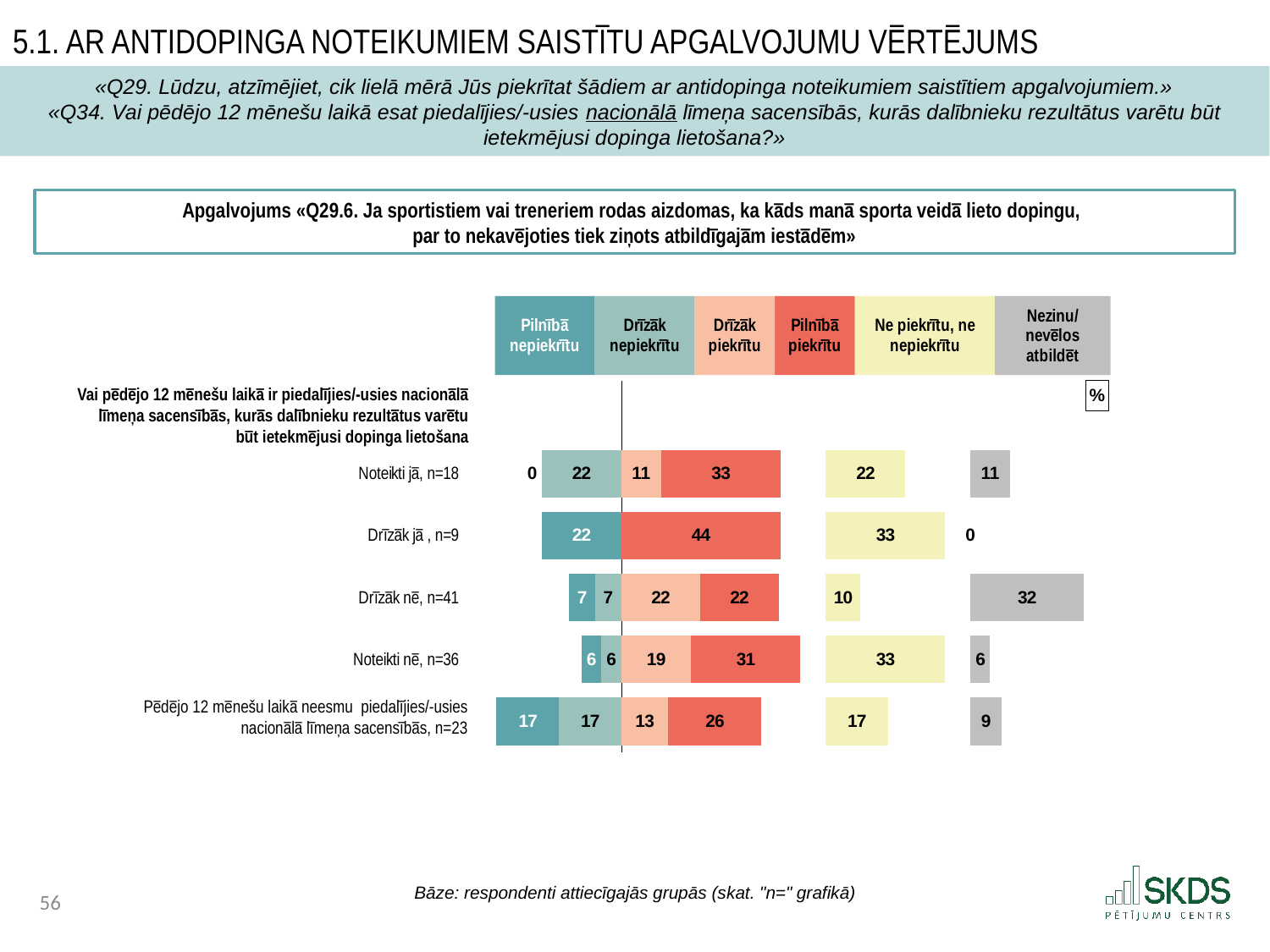
What is the value for "Ne piekrītu, ne nepiekrītu" in the "Noteikti nē, n=36" group? 33 Which group has the highest value for "Pilnībā piekrītu"? Drīzāk jā, n=9 How many respondent groups (rows) are plotted in the chart? 5 Which group has the lowest value for "Nezinu/ nevēlos atbildēt"? Drīzāk jā, n=9 What is the value for "Nezinu/ nevēlos atbildēt" in the "Drīzāk nē, n=41" group? 32 What kind of chart is shown on the slide? Stacked bar chart How many series does the legend list? 6 What is the value for "Pilnībā piekrītu" in the "Noteikti jā, n=18" group? 33 Which is larger: the "Drīzāk piekrītu" value for "Drīzāk nē, n=41" or for "Noteikti nē, n=36"? Drīzāk nē, n=41 What is the value for "Pilnībā nepiekrītu" in the "Pēdējo 12 mēnešu laikā neesmu piedalījies/-usies nacionālā līmeņa sacensībās, n=23" group? 17 What is the difference between the "Pilnībā piekrītu" values for "Noteikti nē, n=36" and "Drīzāk nē, n=41"? 9 What colour represents the "Pilnībā piekrītu" series in the legend? Red